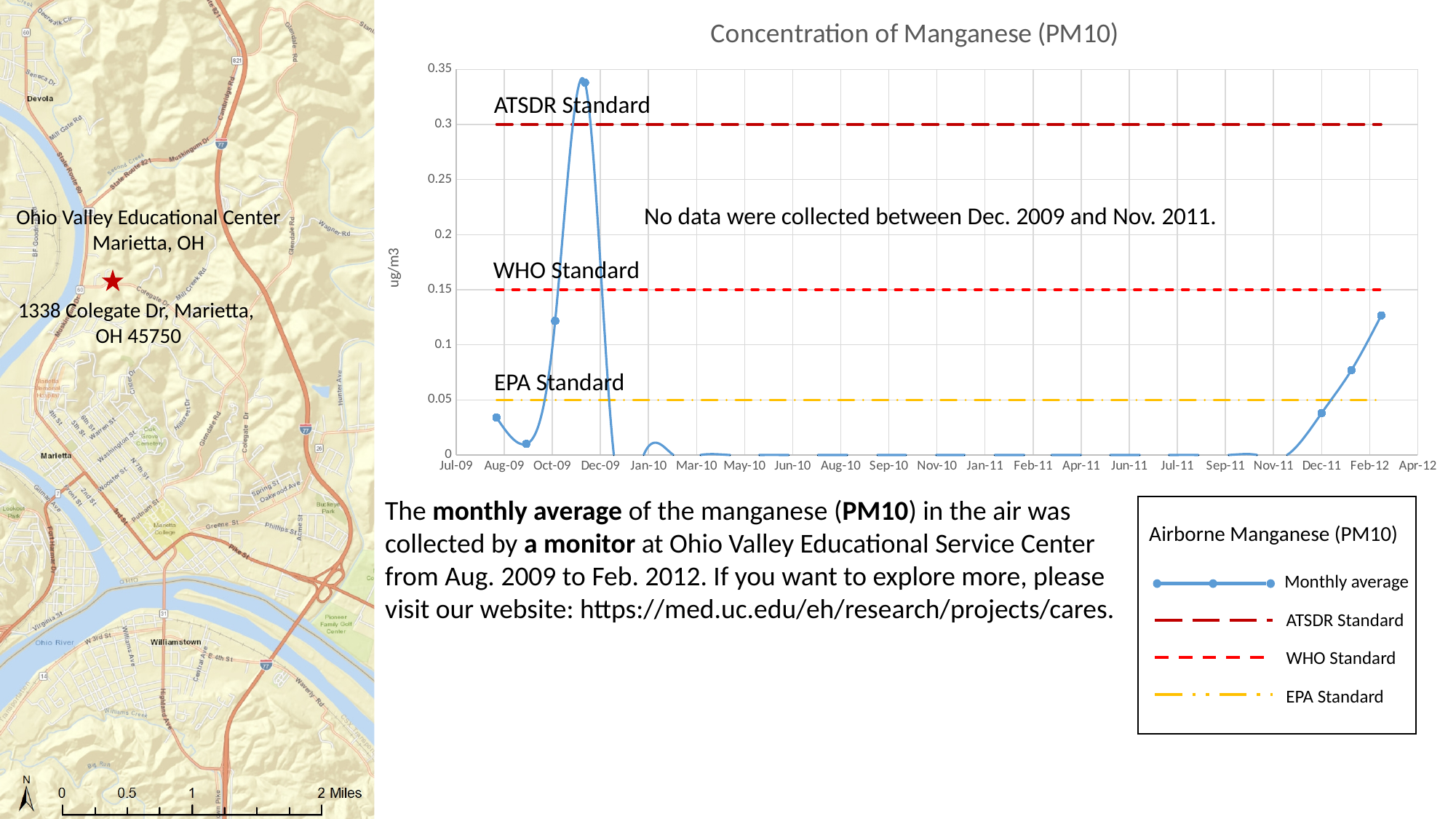
What kind of chart is the Concentration of Manganese (PM10) chart? line chart What is the difference between the ATSDR Standard and the WHO Standard on the Concentration of Manganese (PM10) chart? 0.15 What unit is shown on the vertical axis of the Concentration of Manganese (PM10) chart? ug/m3 What value does the EPA Standard line sit at on the Concentration of Manganese (PM10) chart? 0.05 Is the monthly average for Feb-12 greater or less than 0.1? greater Is the monthly average for Nov-09 greater or less than 0.3? greater In which month does the monthly average reach its highest value on the Concentration of Manganese (PM10) chart? Nov-09 Is the monthly average for Oct-09 greater or less than 0.15? less Which has the larger monthly average, Dec-11 or Feb-12? Feb-12 How many series does the legend of the Concentration of Manganese (PM10) chart list? 4 What value does the WHO Standard line sit at on the Concentration of Manganese (PM10) chart? 0.15 What value does the ATSDR Standard line sit at on the Concentration of Manganese (PM10) chart? 0.3